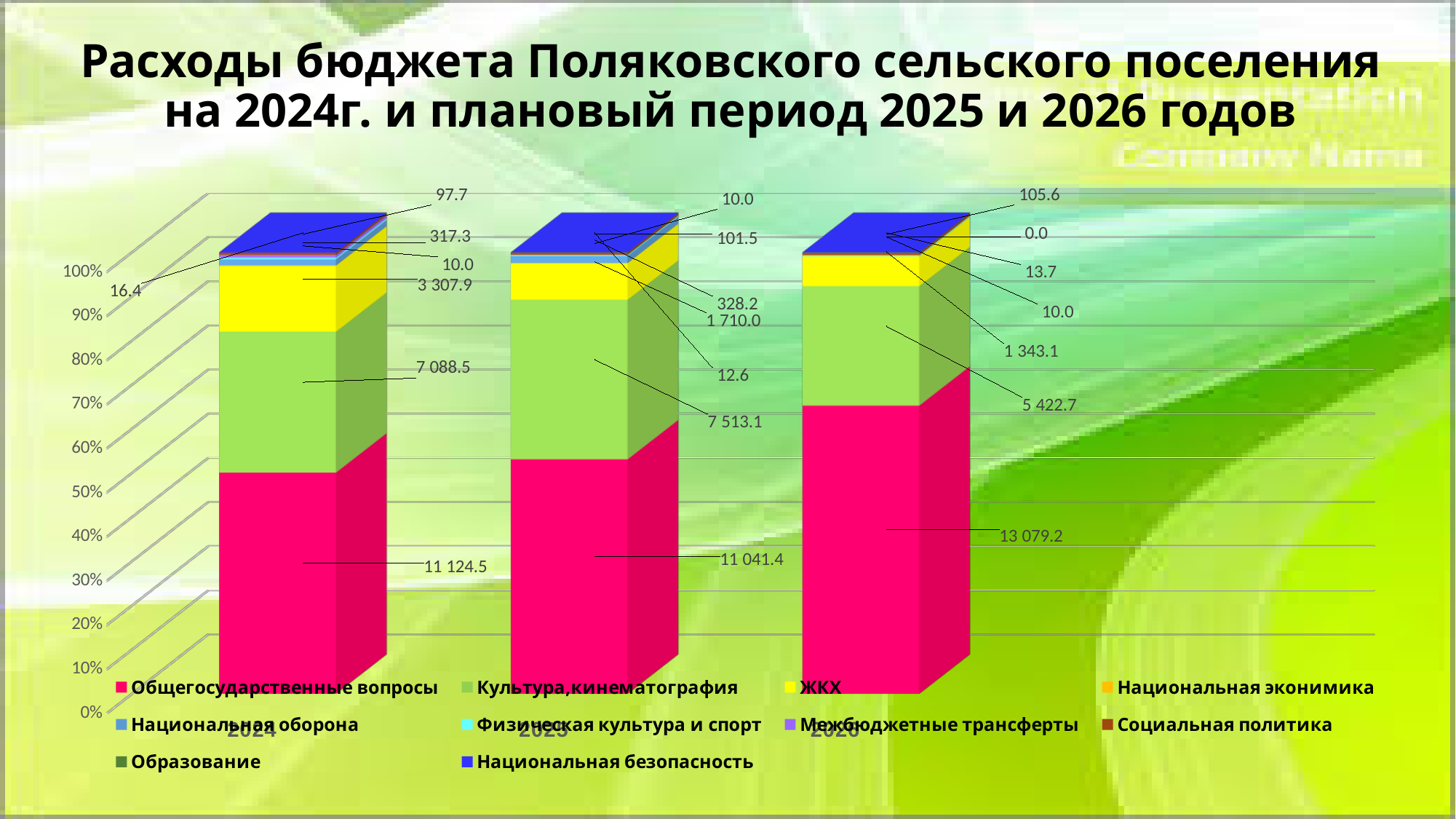
In which year is the value of Общегосударственные вопросы the highest? 2026 What kind of chart is shown on the slide? Stacked bar chart What is the value of Общегосударственные вопросы for 2026? 13 079.2 How many years (categories) are shown on the x axis of the chart? 3 What is the value of Культура,кинематография for 2025? 7 513.1 How many series does the chart legend list? 10 What is the value of ЖКХ for 2024? 3 307.9 What colour represents Общегосударственные вопросы in the legend? Red What is the value of Общегосударственные вопросы for 2024? 11 124.5 What is the difference between Общегосударственные вопросы in 2026 and in 2025? 2 037.8 In which year is the value of Культура,кинематография the lowest? 2026 Which is larger: Культура,кинематография in 2024 or in 2026? 2024